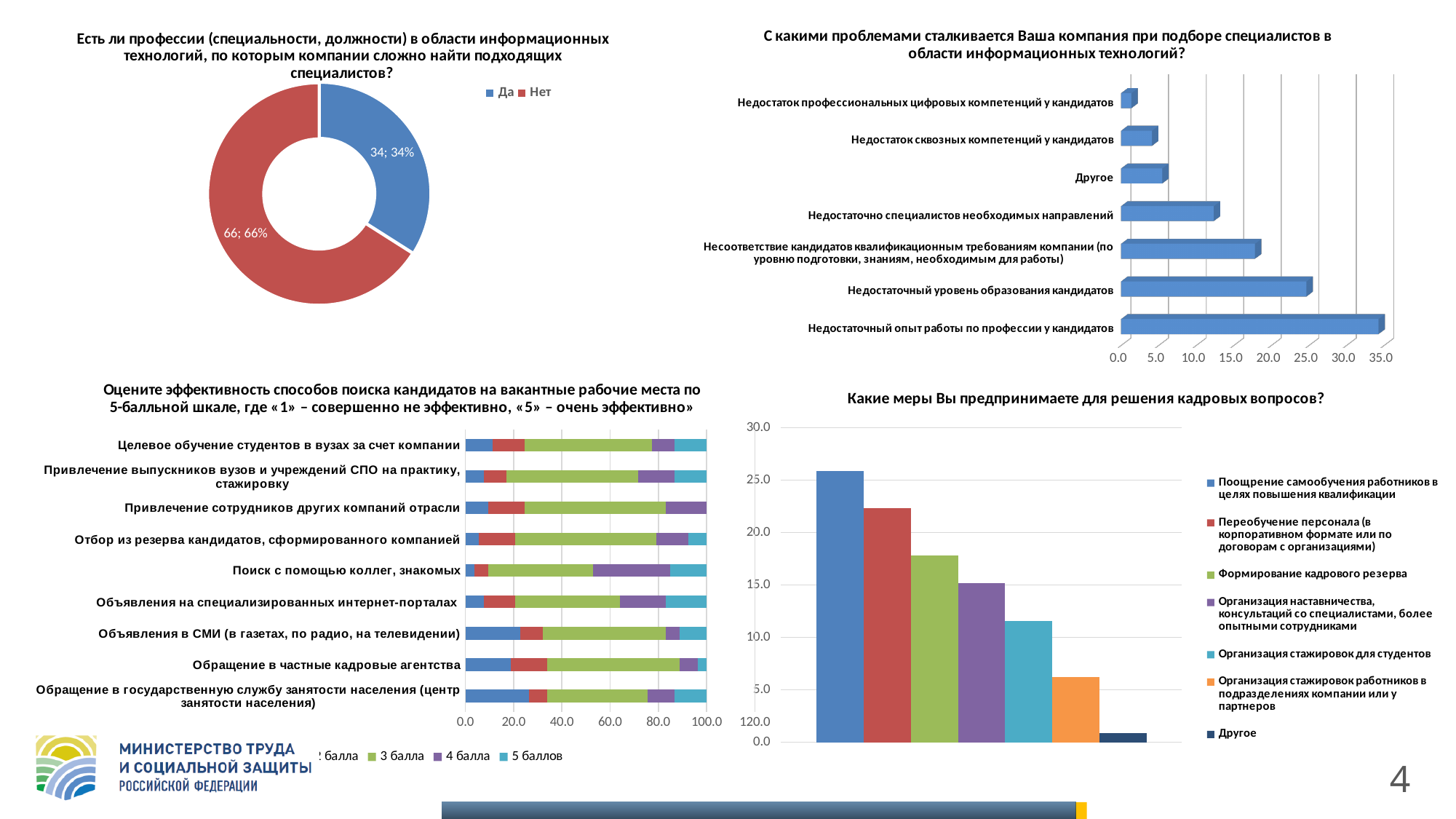
In the doughnut chart at the top left, what share of respondents answered "Да"? 34% In the doughnut chart at the top left, which answer has the larger share, "Да" or "Нет"? Нет In the chart "С какими проблемами сталкивается Ваша компания при подборе специалистов в области информационных технологий?", how many problem categories are shown? 7 In the chart "Какие меры Вы предпринимаете для решения кадровых вопросов?", is the value for "Формирование кадрового резерва" greater or less than 20.0? less In the chart "Какие меры Вы предпринимаете для решения кадровых вопросов?", how many series does the legend list? 7 In the chart "С какими проблемами сталкивается Ваша компания при подборе специалистов в области информационных технологий?", which problem has the lowest value? Недостаток профессиональных цифровых компетенций у кандидатов In the chart "С какими проблемами сталкивается Ваша компания при подборе специалистов в области информационных технологий?", is the value for "Недостаточный уровень образования кандидатов" greater or less than 20.0? greater In the chart "С какими проблемами сталкивается Ваша компания при подборе специалистов в области информационных технологий?", which problem has the highest value? Недостаточный опыт работы по профессии у кандидатов In the chart "Какие меры Вы предпринимаете для решения кадровых вопросов?", which measure has the lowest value? Другое In the chart "Какие меры Вы предпринимаете для решения кадровых вопросов?", which measure has the highest value? Поощрение самообучения работников в целях повышения квалификации In the chart "Оцените эффективность способов поиска кандидатов на вакантные рабочие места по 5-балльной шкале", how many search methods (categories) are listed? 9 In the doughnut chart at the top left, what value is shown for "Нет"? 66; 66%